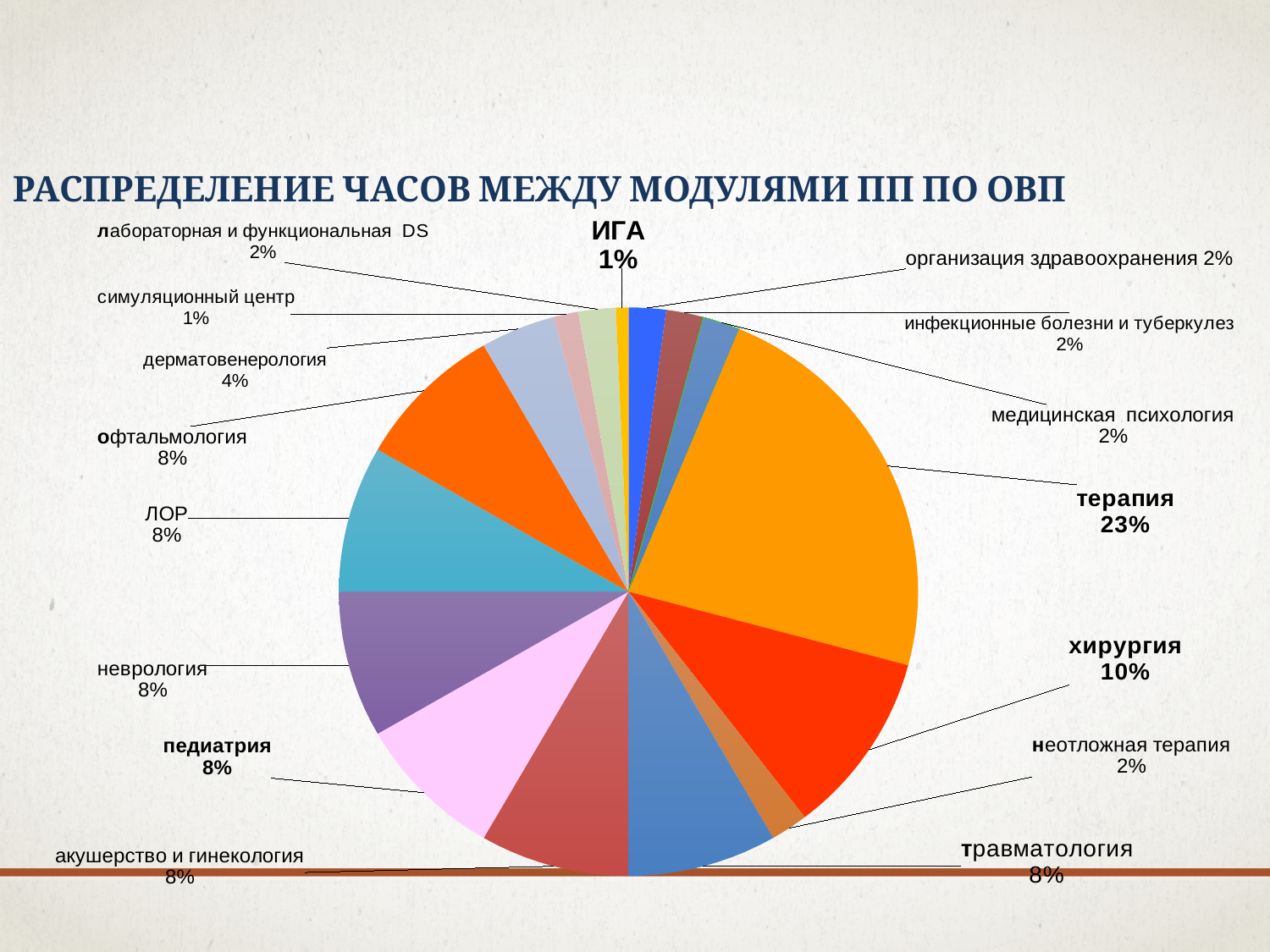
What share of hours does терапия have? 23% Which module has the largest share of hours? терапия What share of hours does хирургия have? 10% What kind of chart is shown on the slide? pie chart What share of hours does педиатрия have? 8% What is the difference in percentage points between терапия and хирургия? 13% What is the title of the chart? РАСПРЕДЕЛЕНИЕ ЧАСОВ МЕЖДУ МОДУЛЯМИ ПП ПО ОВП What share of hours does дерматовенерология have? 4% Which has a larger share, дерматовенерология or медицинская психология? дерматовенерология Which has a larger share, хирургия or травматология? хирургия What share of hours does ИГА have? 1% What share of hours does неотложная терапия have? 2%